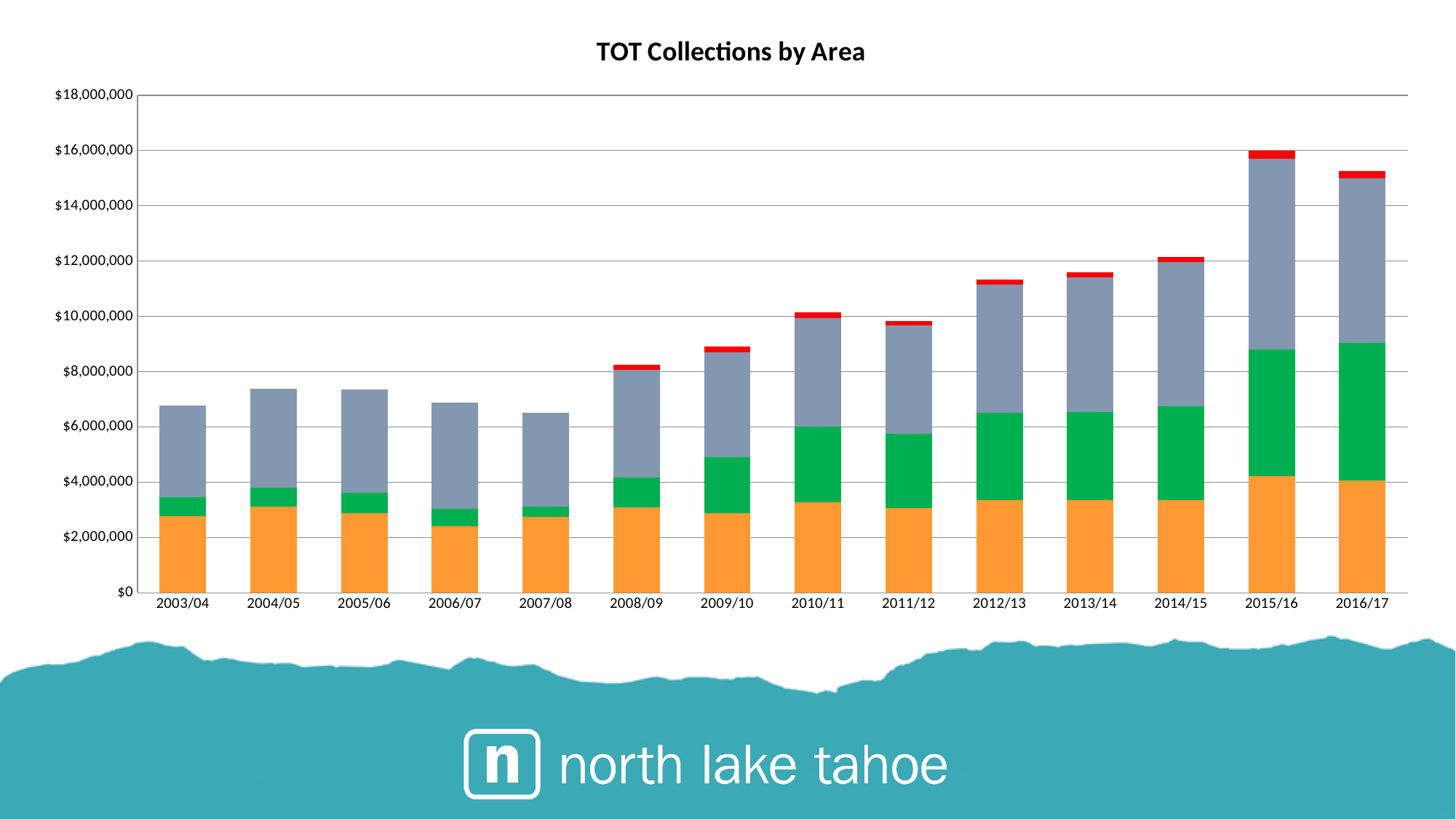
Is the total for 2015/16 greater or less than $14,000,000? greater Which has the larger total TOT collections, 2007/08 or 2008/09? 2008/09 Overall, do total TOT collections rise or fall from 2003/04 to 2016/17? rise Which has the larger total TOT collections, 2015/16 or 2016/17? 2015/16 Is the total for 2012/13 greater or less than $10,000,000? greater Which fiscal year has the highest total TOT collections? 2015/16 Which fiscal year has the lowest total TOT collections? 2007/08 How many fiscal years are shown on the x axis of the chart? 14 Is the total for 2003/04 greater or less than $8,000,000? less What kind of chart is shown on the slide? Stacked bar chart What colour is the bottom segment of each stacked bar? Orange What is the title of the chart? TOT Collections by Area